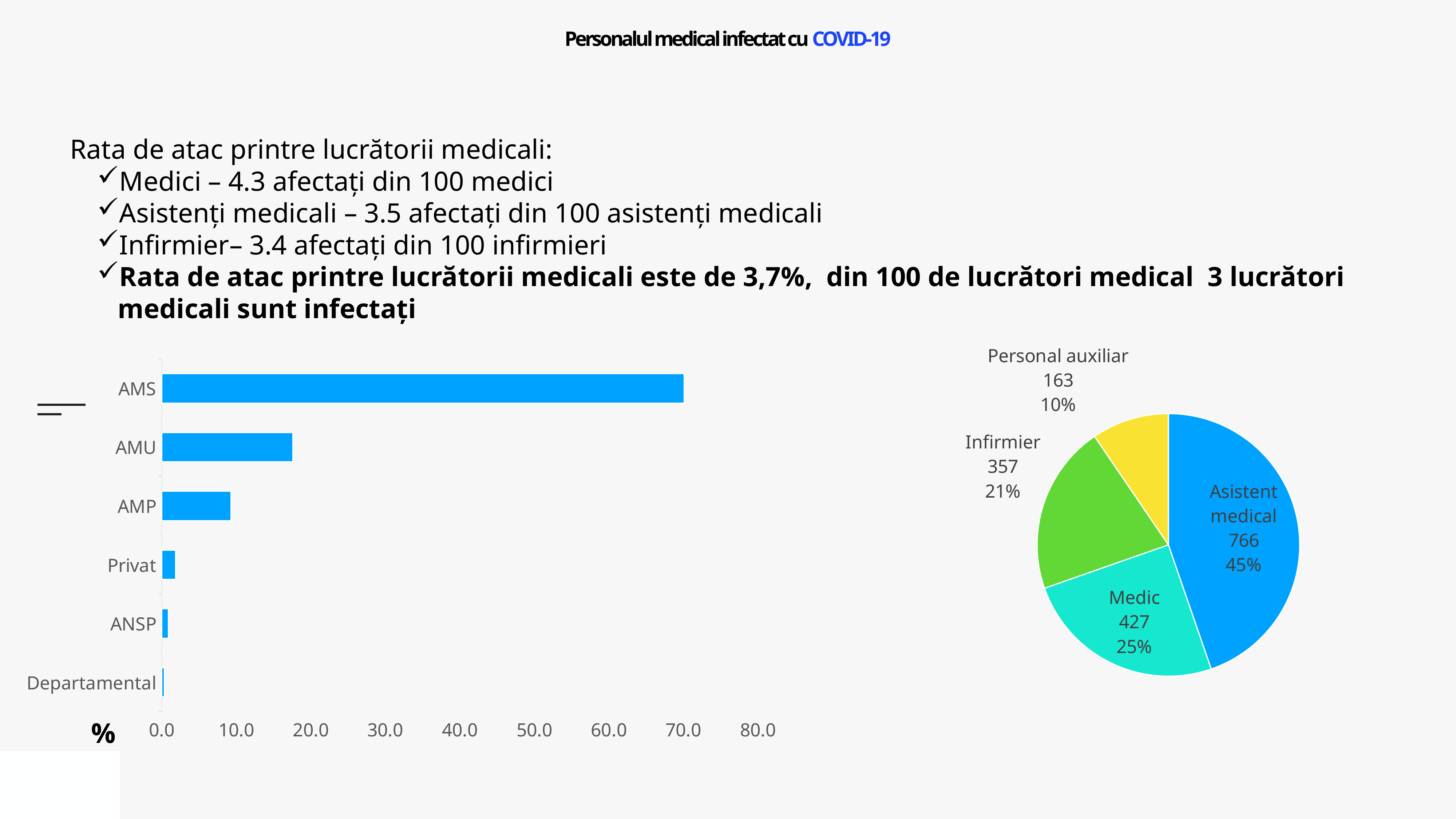
In the pie chart on the right, how many slices are there? 4 In the pie chart on the right, what share does Infirmier represent? 21% In the bar chart on the left, is the value for AMS greater or less than 60.0? greater In the pie chart on the right, what is the difference between the values for Asistent medical and Medic? 339 In the bar chart on the left, which category has the highest value? AMS What kind of chart is the chart on the right side of the slide? pie chart In the bar chart on the left, how many categories are shown? 6 In the pie chart on the right, what is the value for Medic? 427 In the bar chart on the left, is the value for AMU greater or less than 20.0? less What kind of chart is the chart on the left side of the slide? bar chart In the bar chart on the left, which is larger, the value for AMP or the value for Privat? AMP In the bar chart on the left, which category has the lowest value? Departamental